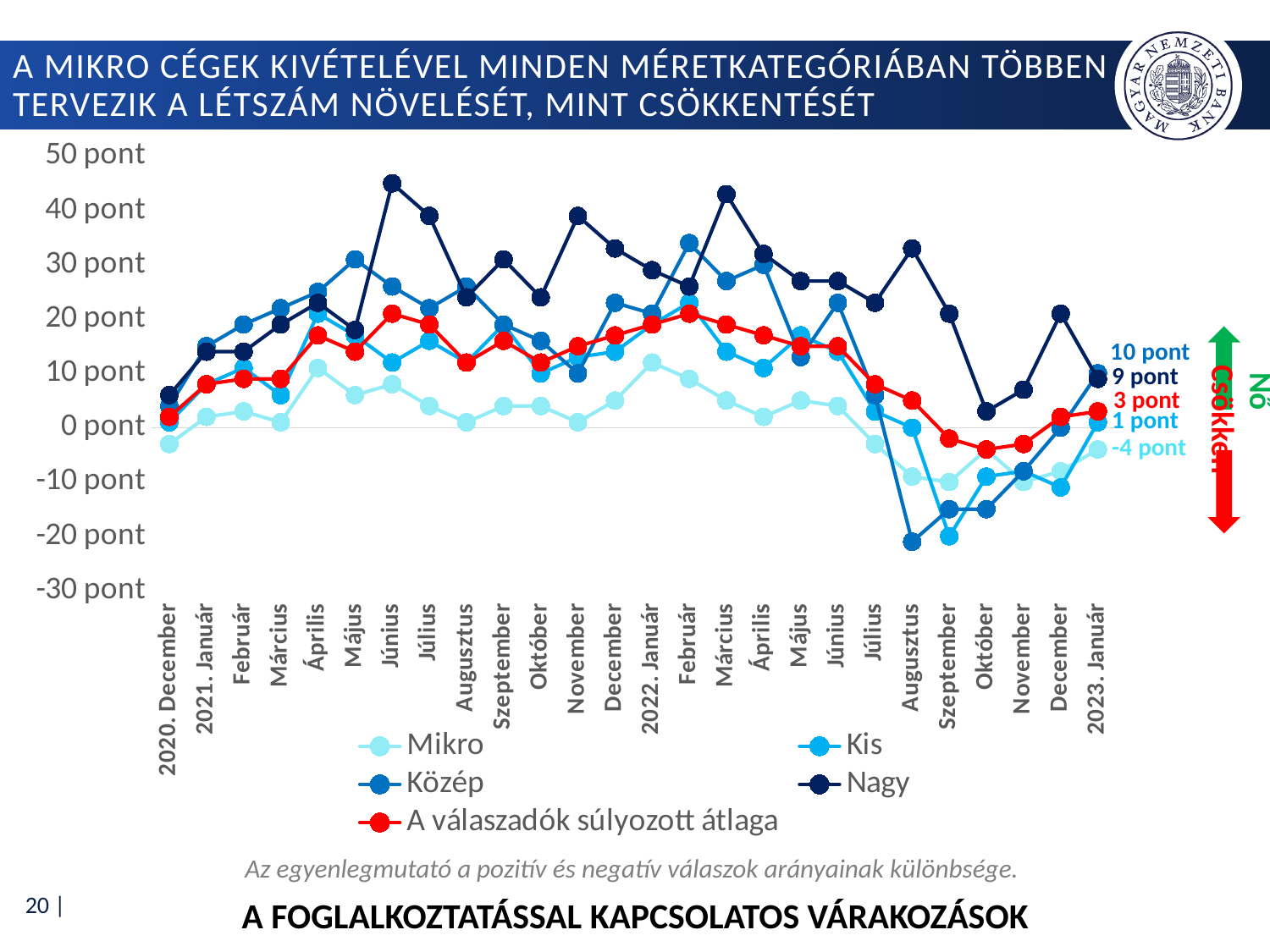
How many months are shown on the x axis? 26 Is the value for Nagy in 2021 Június greater or less than 40 pont? greater Which is larger in 2023. Január, the value for Nagy or the value for Kis? Nagy Which series is drawn in red? A válaszadók súlyozott átlaga What is the value for Nagy in 2023. Január? 9 pont What is the difference between the Közép and Mikro values in 2023. Január? 14 pont How many series does the legend list? 5 What is the value for Mikro in 2023. Január? -4 pont What is the value for A válaszadók súlyozott átlaga in 2023. Január? 3 pont What is the value for Közép in 2023. Január? 10 pont Is the value for Közép in 2022 Augusztus greater or less than -10 pont? less What kind of chart is shown on the slide? line chart